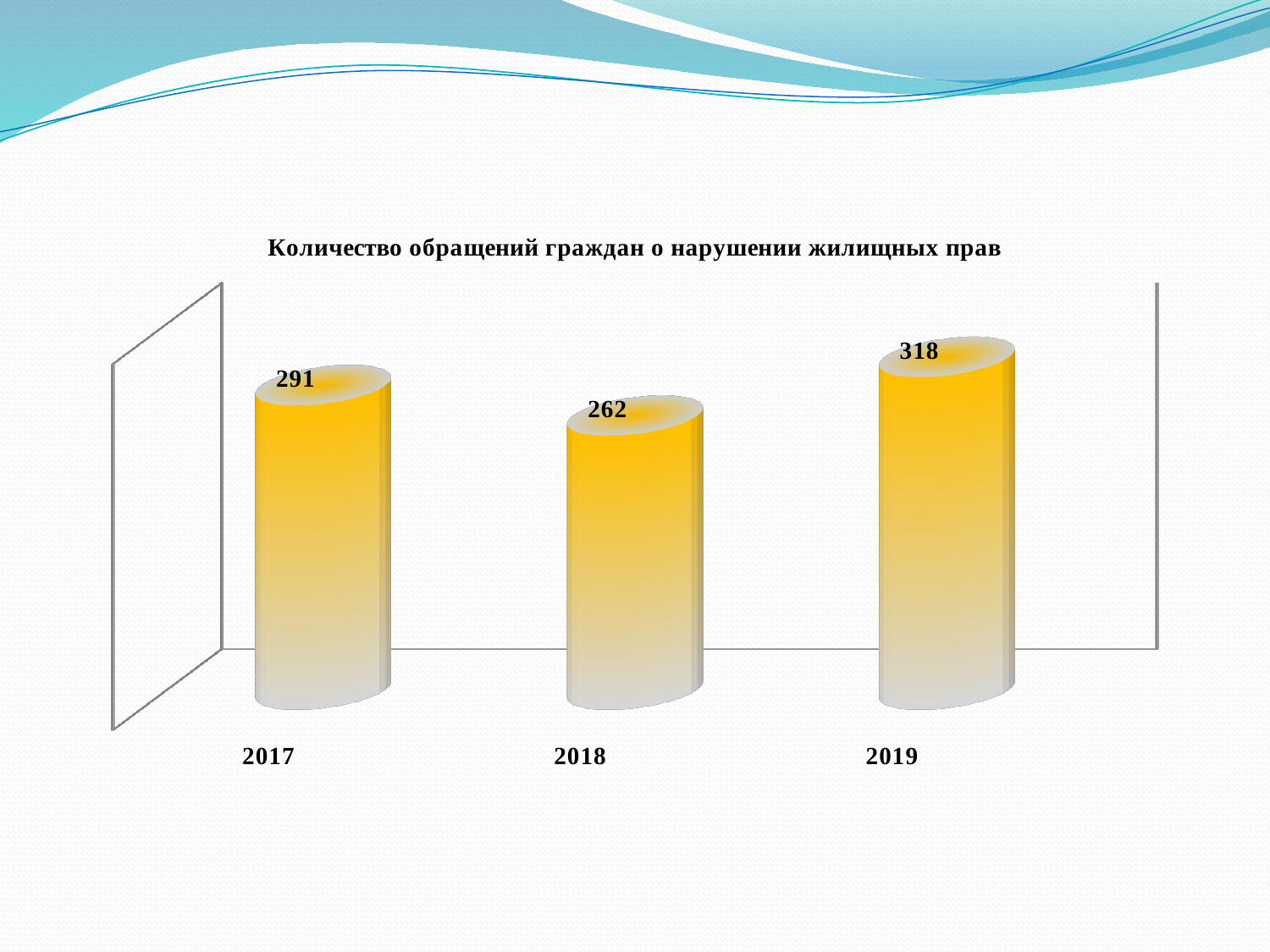
What is the difference between the values for 2019 and 2018? 56 Does the value rise or fall from 2018 to 2019? rise Which year has the lowest value? 2018 Which is larger, the value for 2017 or the value for 2019? 2019 What is the value for 2018? 262 What is the title of the chart? Количество обращений граждан о нарушении жилищных прав Which year has the highest value? 2019 What kind of chart is shown on the slide? bar chart What is the value for 2017? 291 What is the difference between the values for 2017 and 2018? 29 How many years are shown on the chart? 3 What is the value for 2019? 318